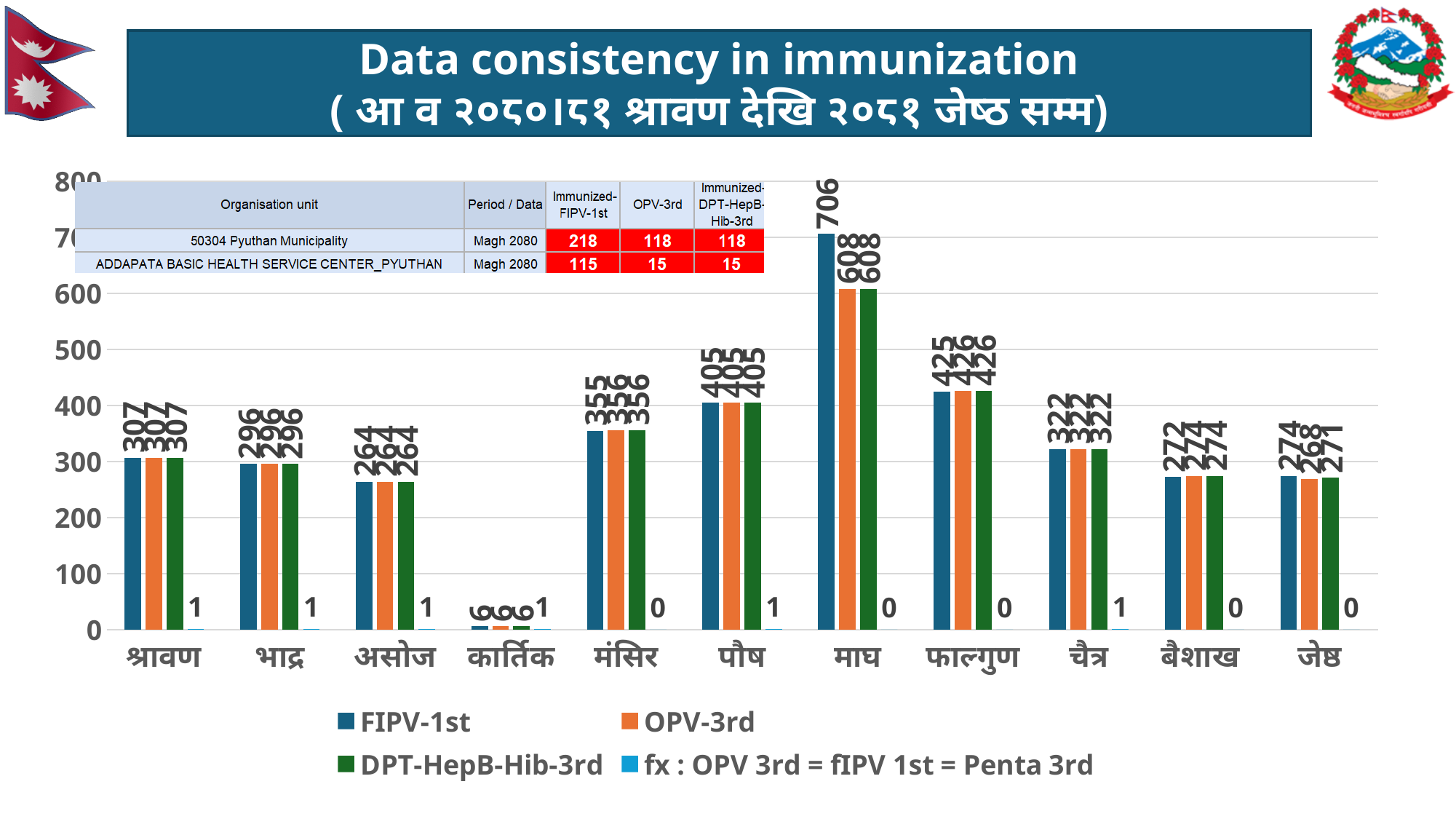
What is the FIPV-1st value for माघ? 706 What is the OPV-3rd value for जेष्ठ? 268 Which month has the highest FIPV-1st value? माघ What is the OPV-3rd value for माघ? 608 How many months are shown on the x axis of the chart? 11 What is the difference between the FIPV-1st and OPV-3rd values for माघ? 98 What colour are the OPV-3rd bars in the chart? orange What is the DPT-HepB-Hib-3rd value for पौष? 405 How many series does the chart legend list? 4 What kind of chart is shown on the slide? bar chart Which is larger, the FIPV-1st value for श्रावण or the FIPV-1st value for असोज? श्रावण Which month has the lowest FIPV-1st value? कार्तिक